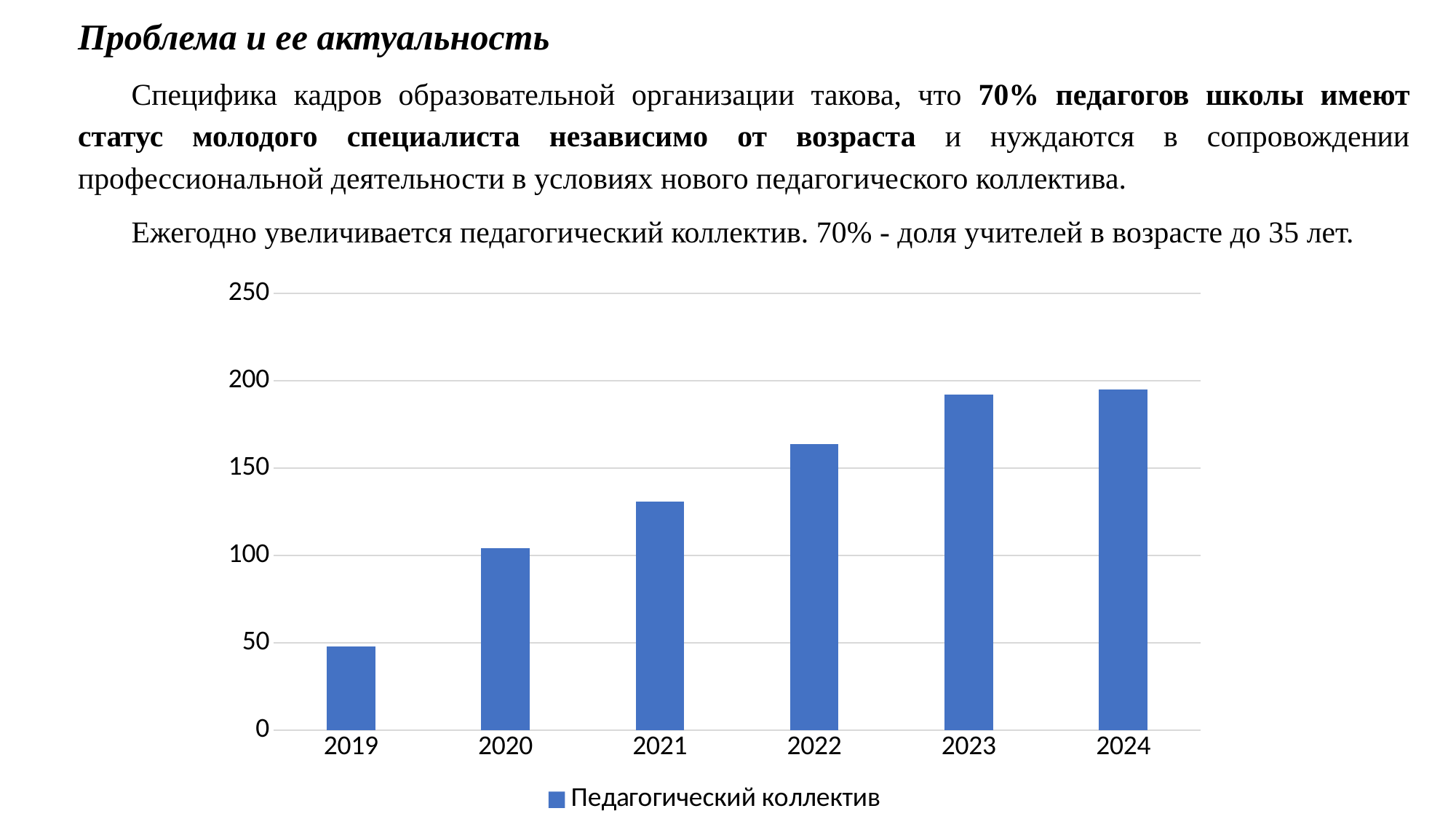
Is the value for 2023 greater or less than 200? less Which year has the lowest value in the chart? 2019 Is the value for 2022 greater or less than 150? greater What kind of chart is shown on the slide? bar chart Do the values in the chart rise or fall from 2019 to 2024? rise Is the value for 2021 greater or less than 150? less How many series does the chart legend list? 1 What is the name of the series shown in the chart legend? Педагогический коллектив Which is larger, the value for 2020 or the value for 2022? 2022 How many years are shown on the x axis of the chart? 6